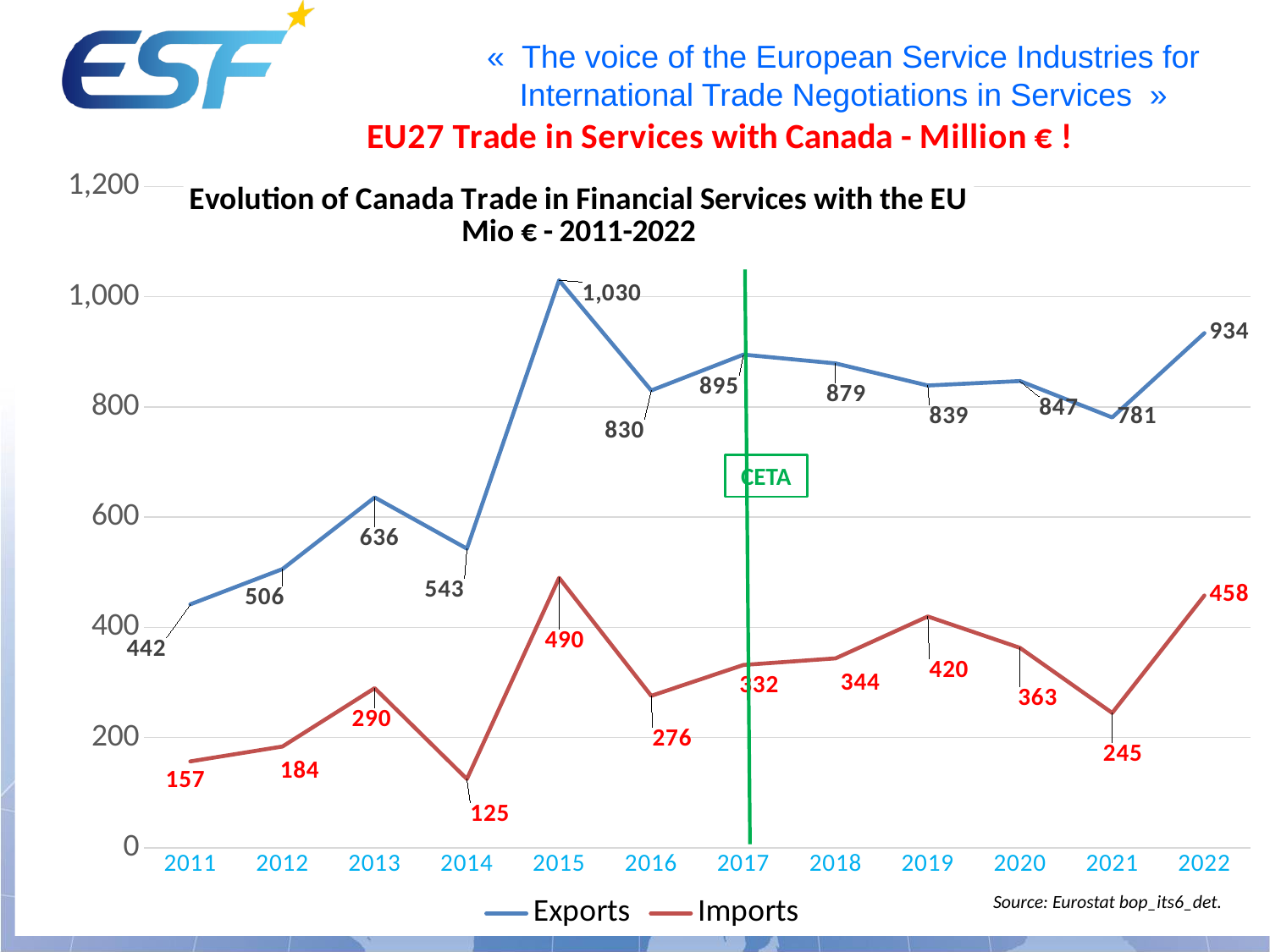
What label is shown in the green box next to the vertical green line? CETA In which year are Imports highest? 2015 What is the value of Imports in 2014? 125 What is the value of Exports in 2015? 1,030 Do Exports rise or fall from 2020 to 2021? Fall How many series does the legend list? 2 What type of chart is shown on the slide? Line chart What is the value of Exports in 2022? 934 In which year are Exports lowest? 2011 Which is larger, Imports in 2019 or Imports in 2020? Imports in 2019 What is the difference between Exports and Imports in 2022? 476 How many years are shown on the x axis? 12